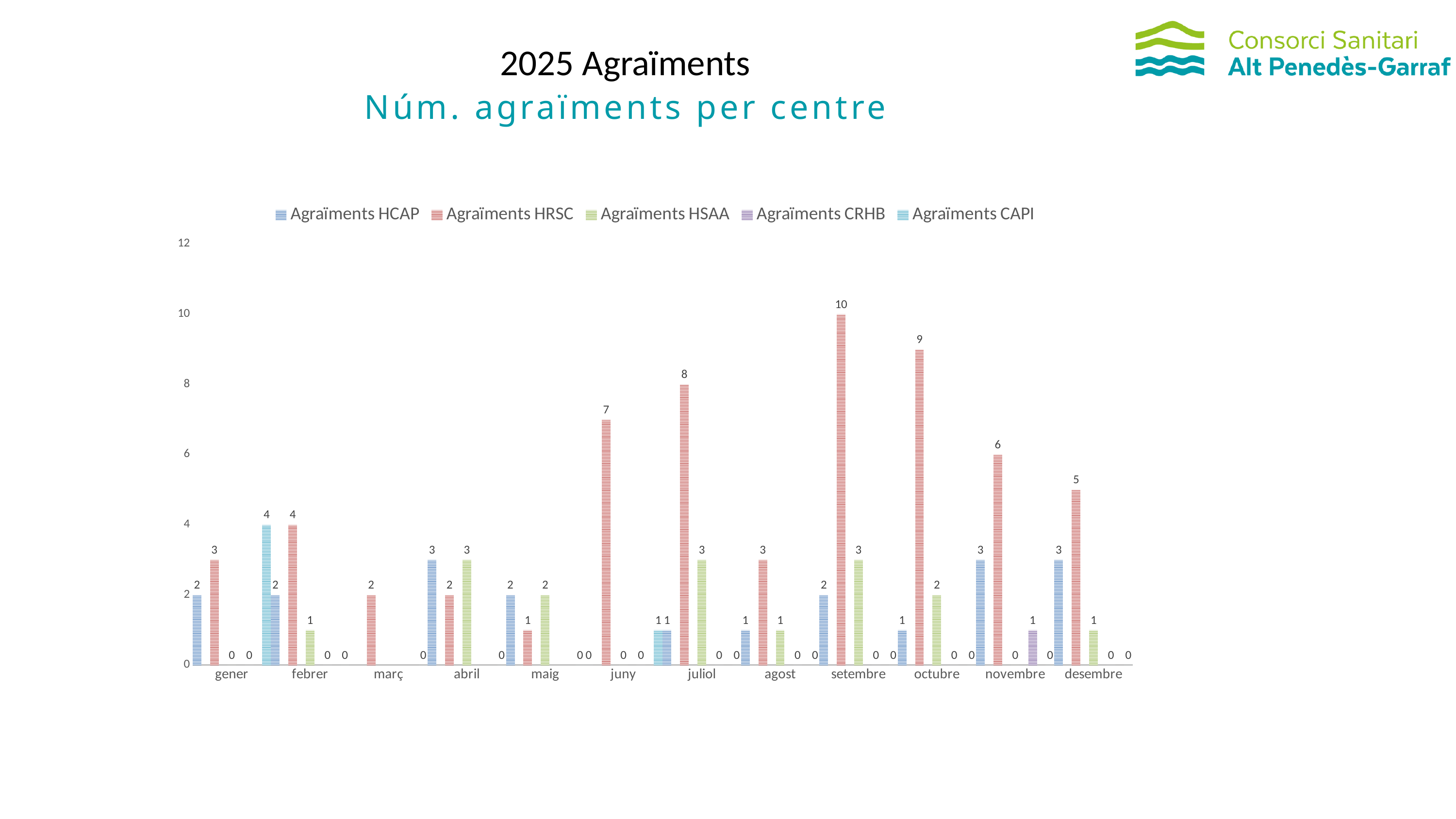
What is the difference between Agraïments HRSC in setembre and in octubre? 1 What is the value of Agraïments HRSC in setembre? 10 How many months are shown on the x axis? 12 What is the value of Agraïments HRSC in octubre? 9 What is the value of Agraïments HRSC in juliol? 8 What kind of chart is shown on the slide? bar chart In which month is Agraïments HRSC highest? setembre What is the subtitle of the chart on the slide? Núm. agraïments per centre Which is larger, Agraïments HRSC in juny or Agraïments HRSC in novembre? juny What is the value of Agraïments HCAP in abril? 3 How many series does the legend list? 5 What is the value of Agraïments CRHB in novembre? 1